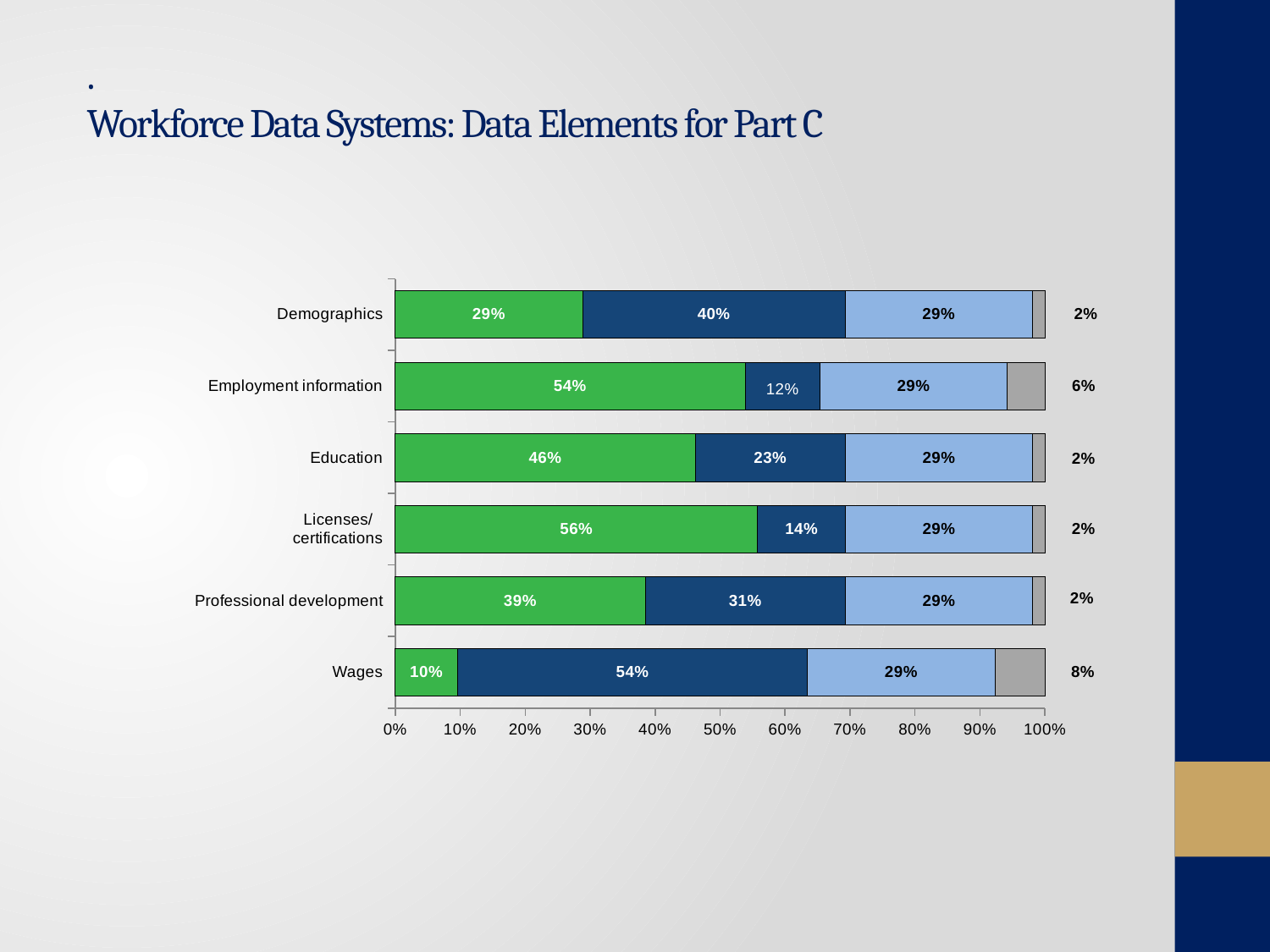
Which category has the largest green segment? Licenses/certifications What is the value of the dark blue segment for Licenses/certifications? 14% Which category has the largest grey segment? Wages What kind of chart is shown on the slide? Stacked bar chart What is the value of the green segment for Wages? 10% What is the value of the dark blue segment for Demographics? 40% Which category has the smallest green segment? Wages Which is larger: the dark blue segment for Wages or the dark blue segment for Professional development? Wages How many categories are plotted on the chart? 6 What is the title of the slide containing the chart? Workforce Data Systems: Data Elements for Part C What is the value of the grey segment for Employment information? 6% What is the difference between the green segment for Education and the green segment for Professional development? 7%